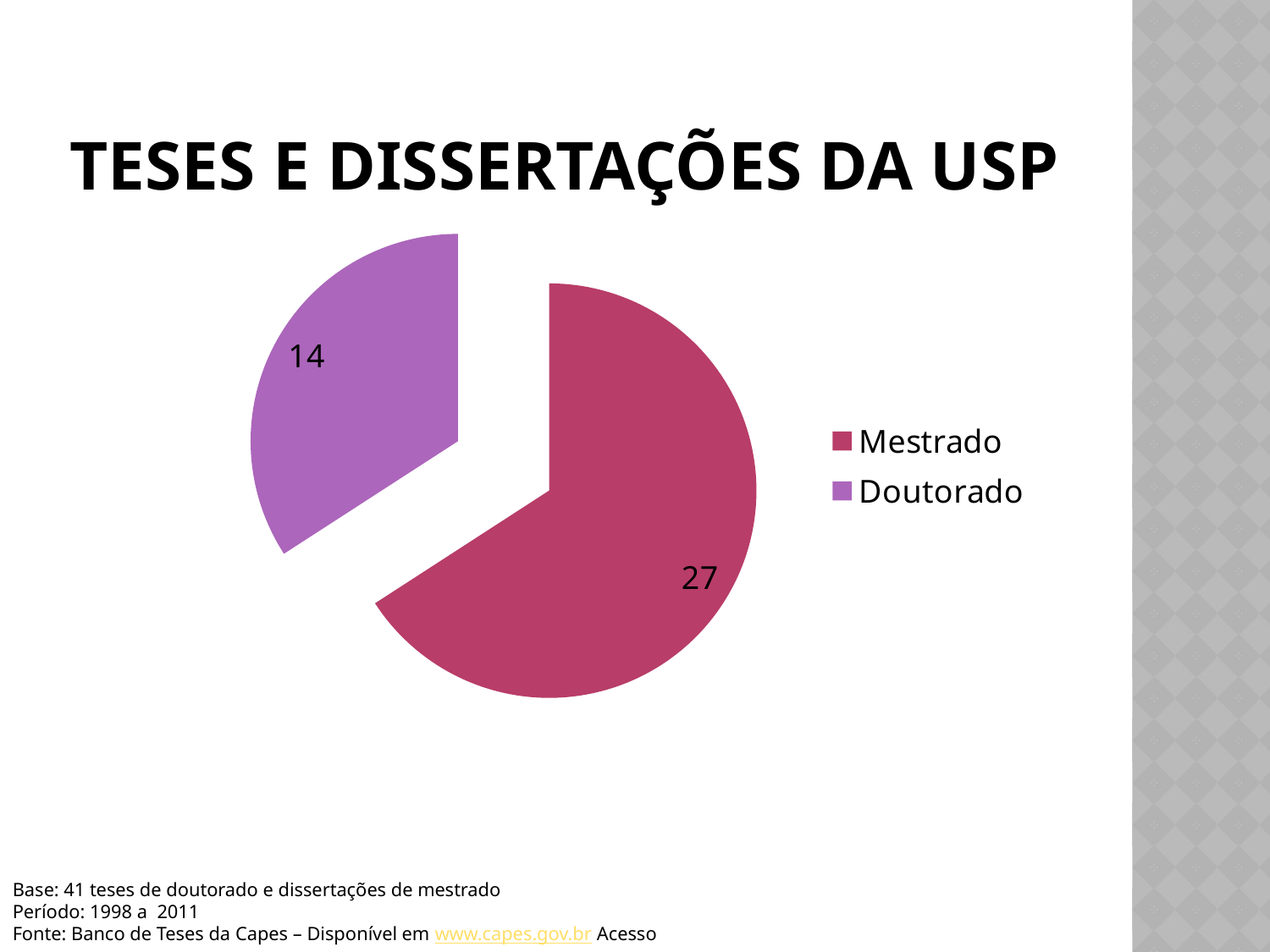
What is the total of the two slices? 41 What is the difference between the Mestrado and Doutorado values? 13 What is the value for Doutorado? 14 What is the title of the slide containing the chart? TESES E DISSERTAÇÕES DA USP What colour is the Doutorado slice? purple How many entries does the legend list? 2 What kind of chart is shown on the slide? pie chart Which category has the largest slice? Mestrado Which is larger, Mestrado or Doutorado? Mestrado Which category has the smallest slice? Doutorado How many categories does the pie chart show? 2 What is the value for Mestrado? 27